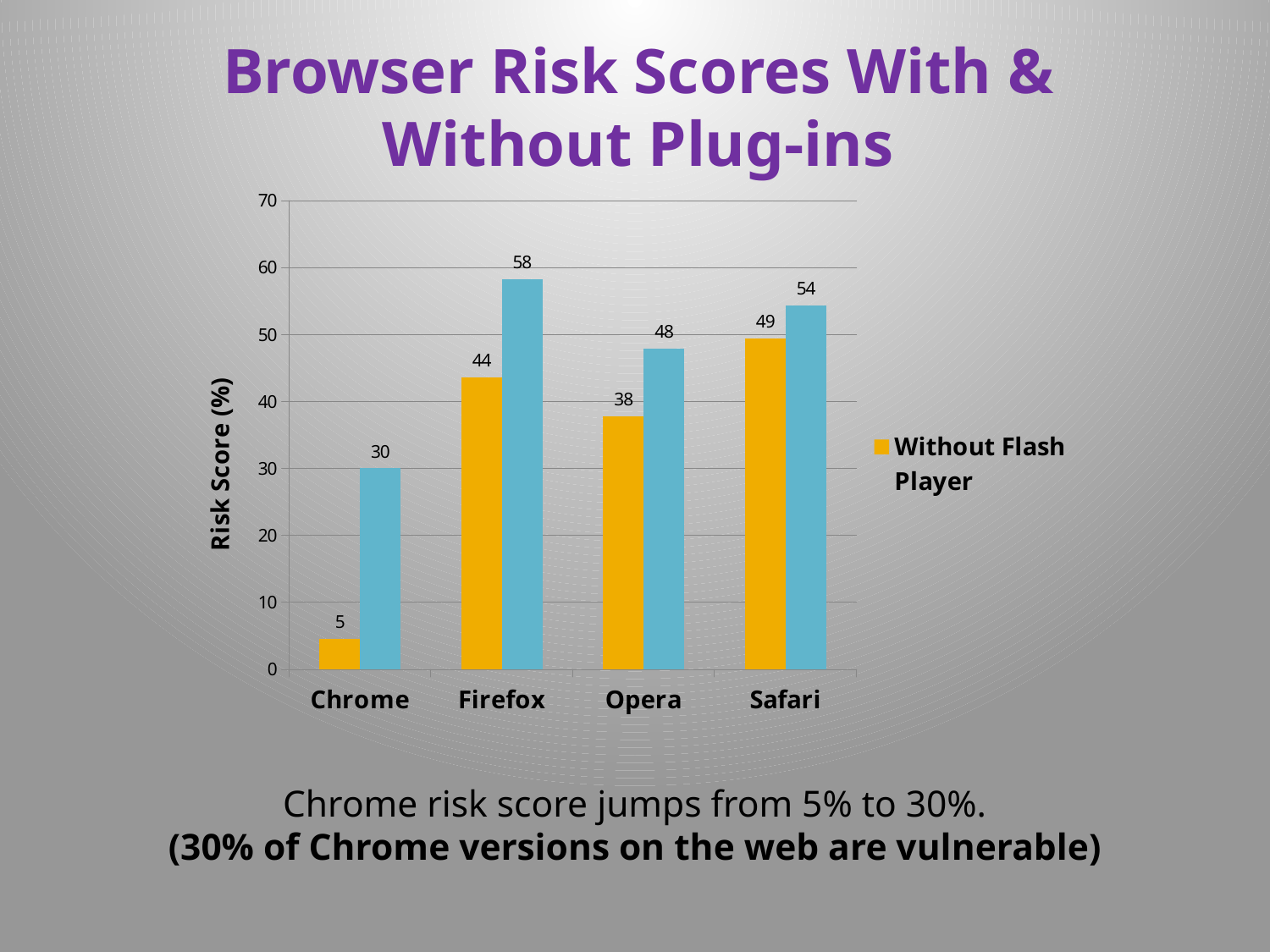
What is the difference between the blue bar and the Without Flash Player bar for Firefox? 14 What kind of chart is shown on the slide? bar chart Is the Without Flash Player value for Opera greater or less than 40? less What is the difference between the blue bar and the Without Flash Player bar for Chrome? 25 What is the Without Flash Player risk score for Firefox? 44 What value does the blue bar for Safari show? 54 How many browsers are shown on the x axis? 4 Which browser has the highest blue bar? Firefox What value does the blue bar for Opera show? 48 Which browser has the highest Without Flash Player risk score? Safari Which browser has the lowest Without Flash Player risk score? Chrome Which is larger: the blue bar for Firefox or the blue bar for Safari? Firefox